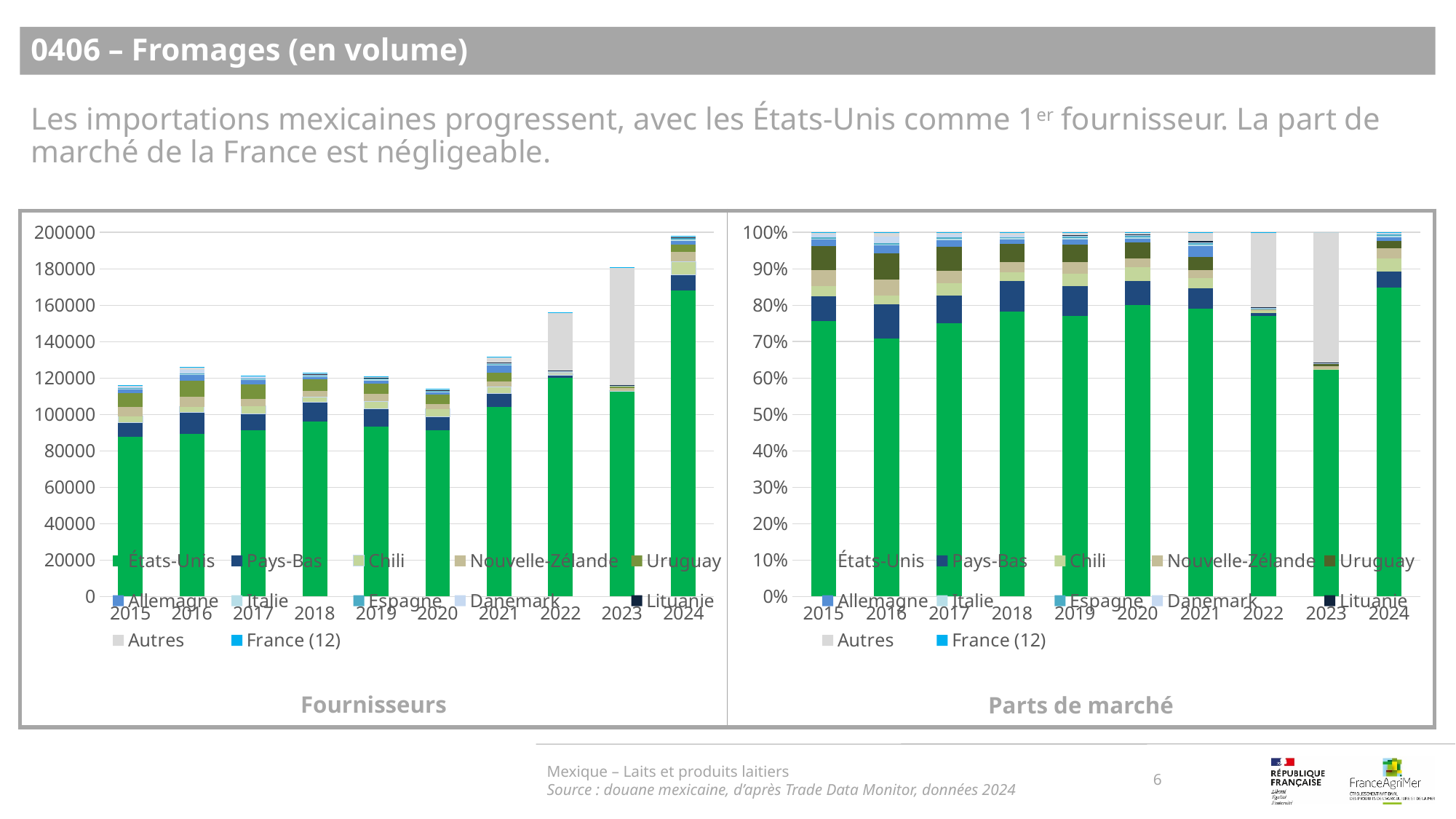
In the 'Parts de marché' chart, is the share of États-Unis in 2023 greater or less than 70%? less How many years are shown on the x axis of the 'Fournisseurs' chart? 10 In the 'Parts de marché' chart, is the share of États-Unis in 2024 greater or less than 80%? greater In the 'Fournisseurs' chart, is the total for 2024 greater or less than 180000? greater How many series does the legend of the 'Parts de marché' chart list? 12 Which series is shown in light grey in the legend of the 'Fournisseurs' chart? Autres What kind of chart is the 'Fournisseurs' chart on the left? stacked bar chart In the 'Fournisseurs' chart, which year has the highest total bar? 2024 In the 'Fournisseurs' chart, which total is larger, 2015 or 2024? 2024 In the 'Parts de marché' chart, which year has the larger share for États-Unis, 2023 or 2024? 2024